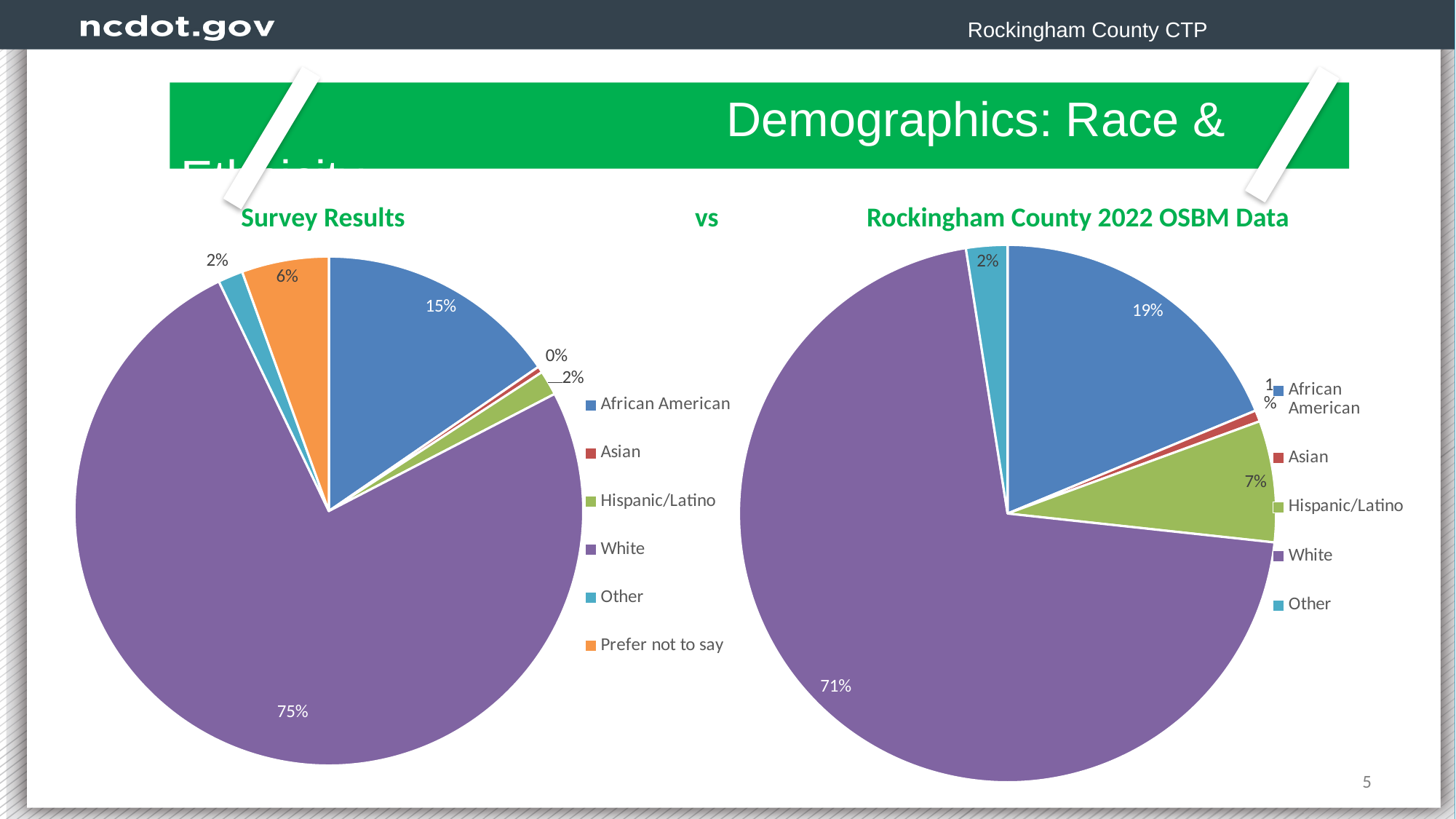
How many categories does the legend of the Survey Results pie chart list? 6 What is the difference between the White share in the Survey Results chart and the White share in the Rockingham County 2022 OSBM Data chart? 4% What type of chart is the Rockingham County 2022 OSBM Data chart? Pie chart In the Rockingham County 2022 OSBM Data pie chart, what share is African American? 19% In the Rockingham County 2022 OSBM Data pie chart, what share is Hispanic/Latino? 7% In the Survey Results pie chart, which category has the smallest slice? Asian In the Rockingham County 2022 OSBM Data pie chart, what share is White? 71% Which is larger: the Hispanic/Latino share in the Survey Results chart or in the Rockingham County 2022 OSBM Data chart? Rockingham County 2022 OSBM Data In the Survey Results pie chart, which category has the largest slice? White In the Survey Results pie chart, what share is African American? 15% In the Survey Results pie chart, what share is Prefer not to say? 6% In the Survey Results pie chart, what share is White? 75%